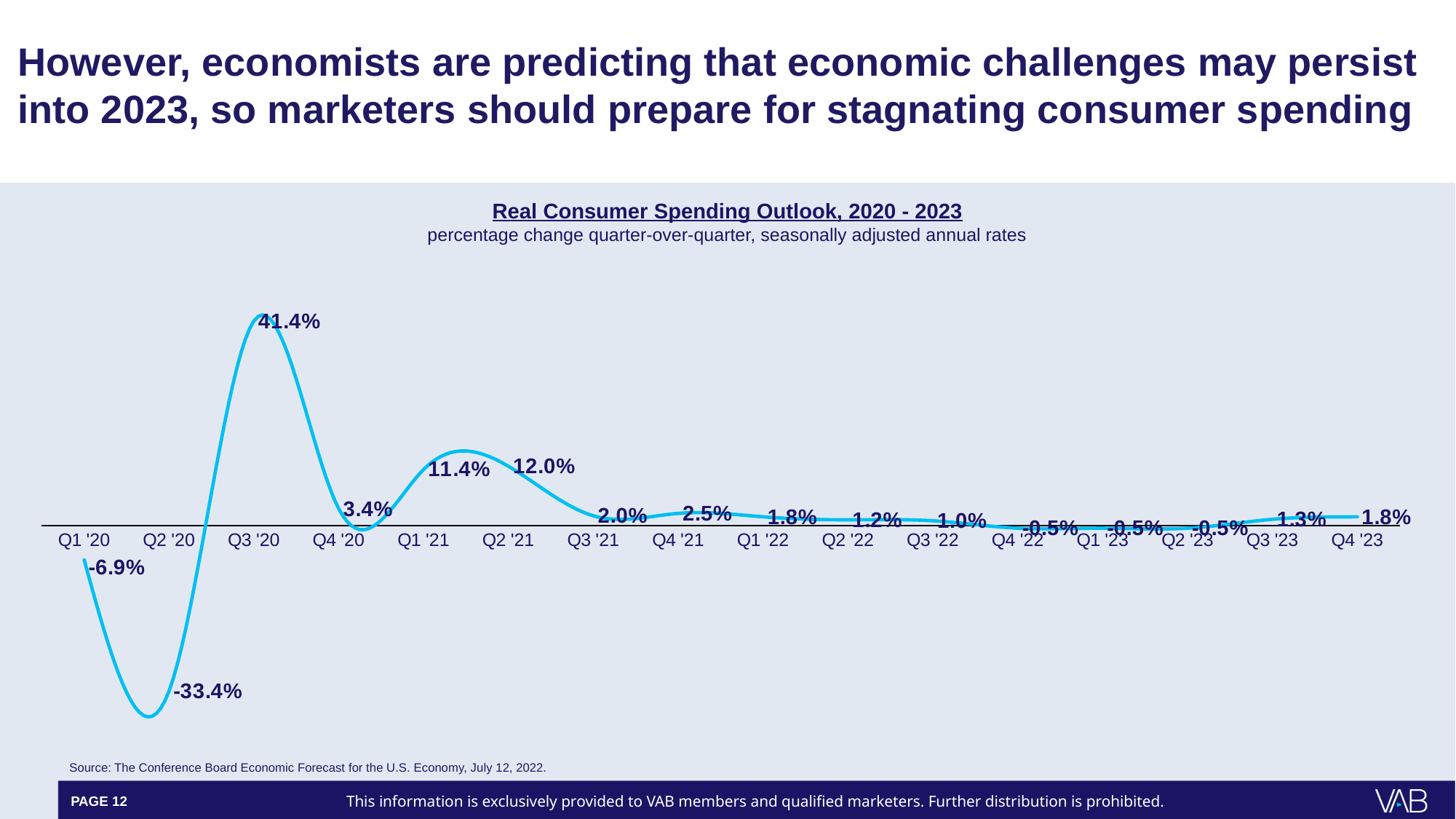
What is the title of the chart? Real Consumer Spending Outlook, 2020 - 2023 How many quarters are plotted on the chart? 16 Which is larger, the value for Q4 '21 or the value for Q3 '21? Q4 '21 Which quarter has the lowest value? Q2 '20 What type of chart is shown on the slide? line chart What is the difference between the values for Q2 '21 and Q1 '21? 0.6% What is the value for Q3 '20? 41.4% What is the value for Q2 '21? 12.0% Do the values rise or fall from Q3 '20 to Q4 '20? fall What is the value for Q2 '20? -33.4% Which quarter has the highest value? Q3 '20 What is the value for Q4 '23? 1.8%